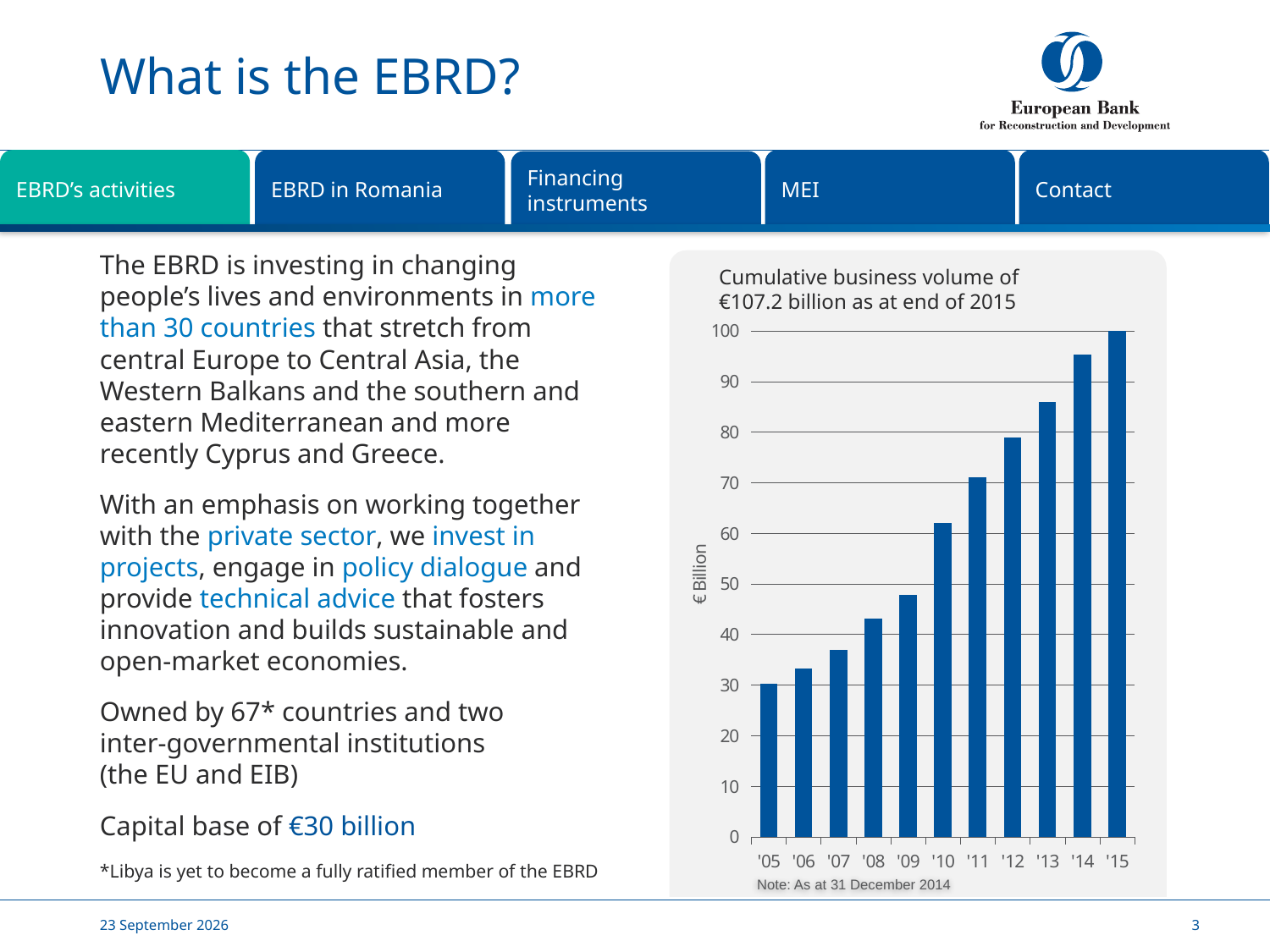
Which year has the highest bar on the chart? '15 Which year has the lowest bar on the chart? '05 What kind of chart is shown on the slide? bar chart Is the value for '13 greater or less than 80? greater Which is larger, the value for '09 or the value for '12? '12 How many years are plotted on the chart? 11 What is the label on the vertical axis of the chart? € Billion Do the values rise or fall from '05 to '15? rise Is the value for '14 greater or less than 90? greater Is the value for '10 greater or less than 50? greater What is the title of the chart? Cumulative business volume of €107.2 billion as at end of 2015